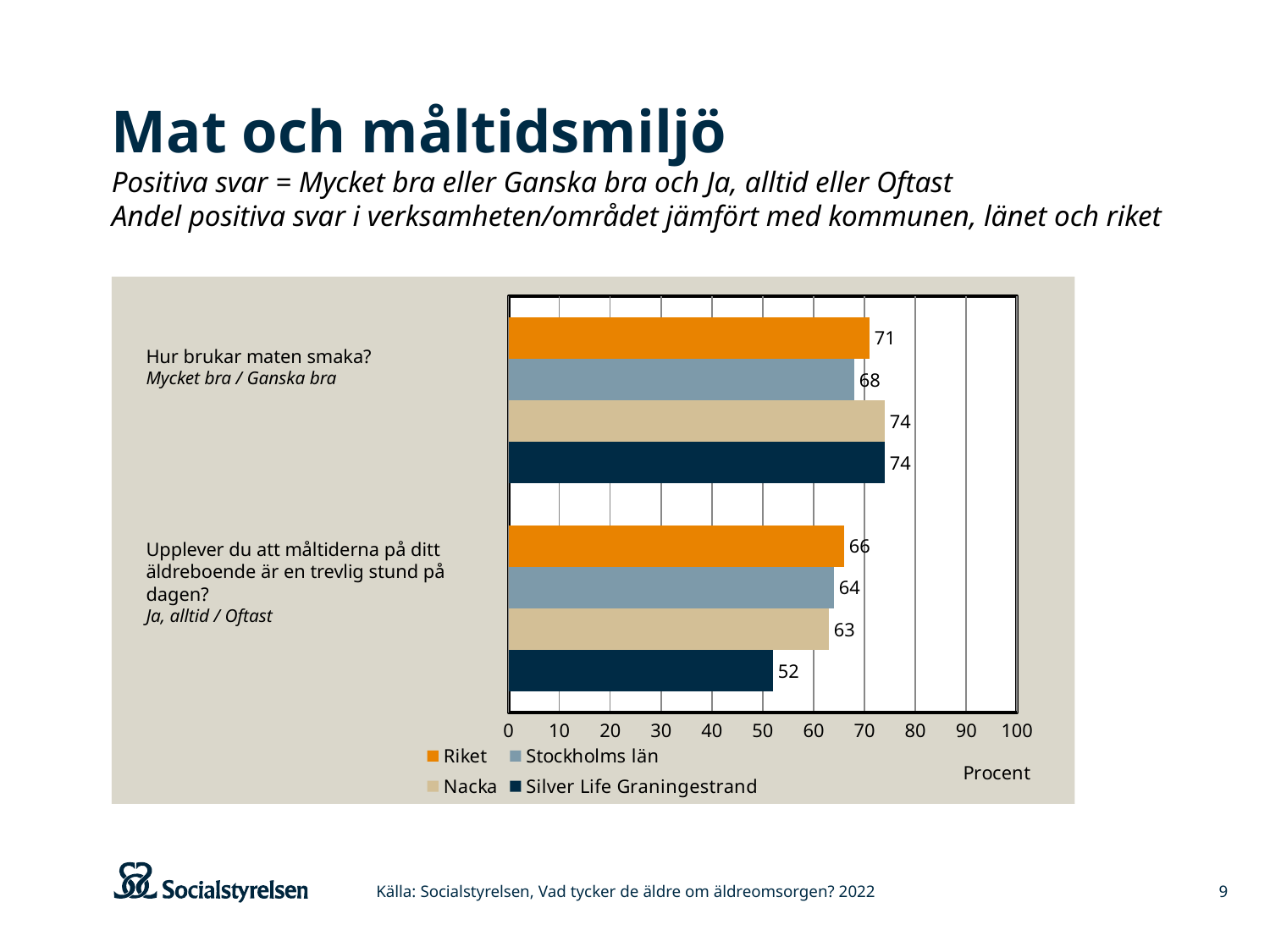
What is the value for Riket on the question "Hur brukar maten smaka?"? 71 What is the value for Stockholms län on the question "Hur brukar maten smaka?"? 68 Which series has the lowest value on the question "Hur brukar maten smaka?"? Stockholms län What is the value for Silver Life Graningestrand on the question "Upplever du att måltiderna på ditt äldreboende är en trevlig stund på dagen?"? 52 How many questions (categories) are shown in the chart? 2 What is the label of the x axis? Procent Which series has the lowest value on the question "Upplever du att måltiderna på ditt äldreboende är en trevlig stund på dagen?"? Silver Life Graningestrand Which is larger on the question "Hur brukar maten smaka?": Riket or Stockholms län? Riket What is the difference between Riket and Silver Life Graningestrand on the question "Upplever du att måltiderna på ditt äldreboende är en trevlig stund på dagen?"? 14 How many series does the legend list? 4 What is the value for Nacka on the question "Upplever du att måltiderna på ditt äldreboende är en trevlig stund på dagen?"? 63 What kind of chart is shown on the slide? Bar chart